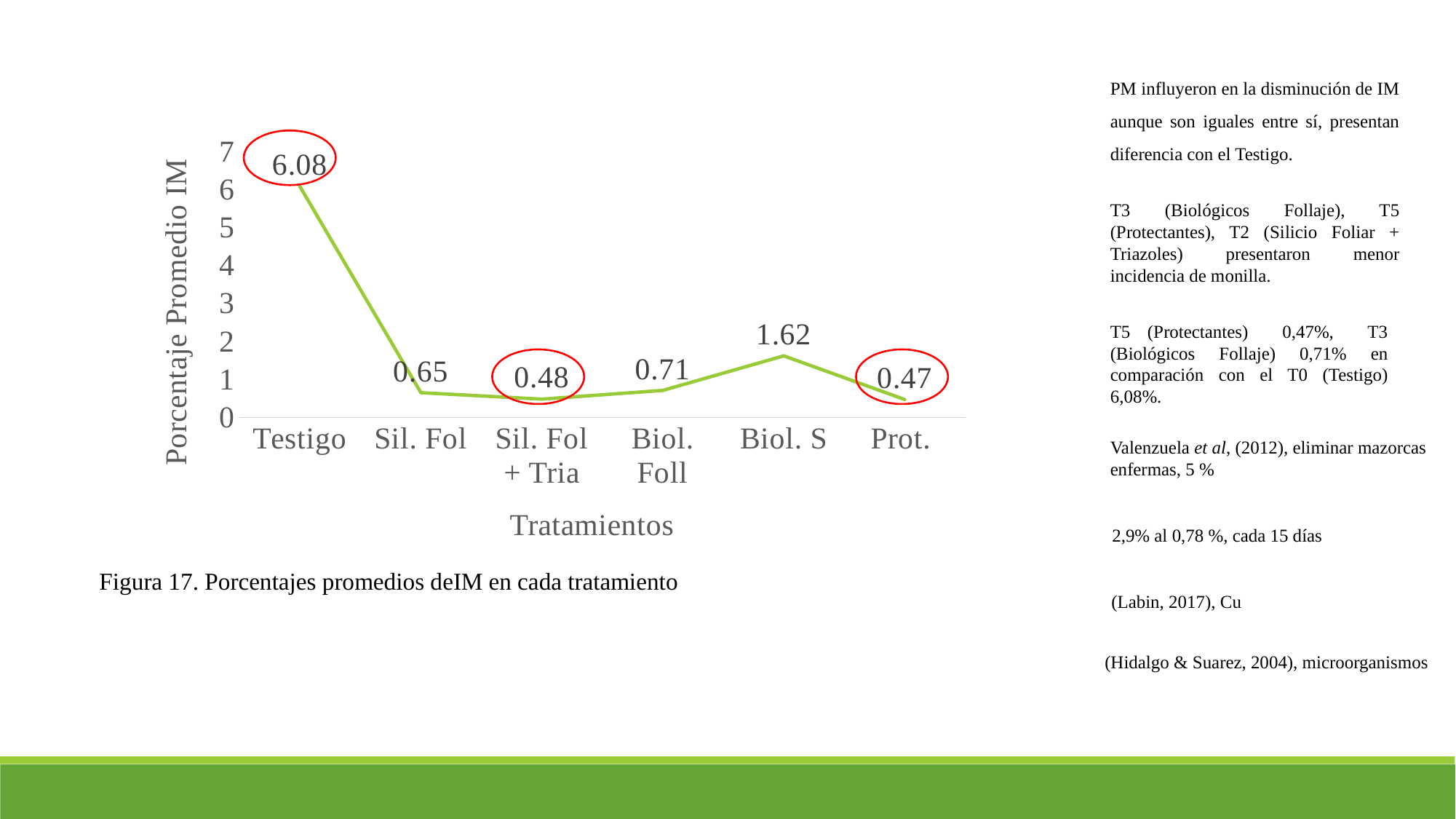
What is the value for Sil. Fol + Tria? 0.48 Is the value for Biol. S greater or less than 1? greater What is the value for Testigo? 6.08 Which treatment has the highest value? Testigo What is the difference between the values for Testigo and Biol. S? 4.46 Which is larger, the value for Biol. Foll or the value for Sil. Fol? Biol. Foll What is the value for Biol. S? 1.62 Which treatment has the lowest value? Prot. What is the label of the y axis? Porcentaje Promedio IM What kind of chart is this? line chart What is the value for Prot.? 0.47 How many treatments are plotted on the x axis? 6